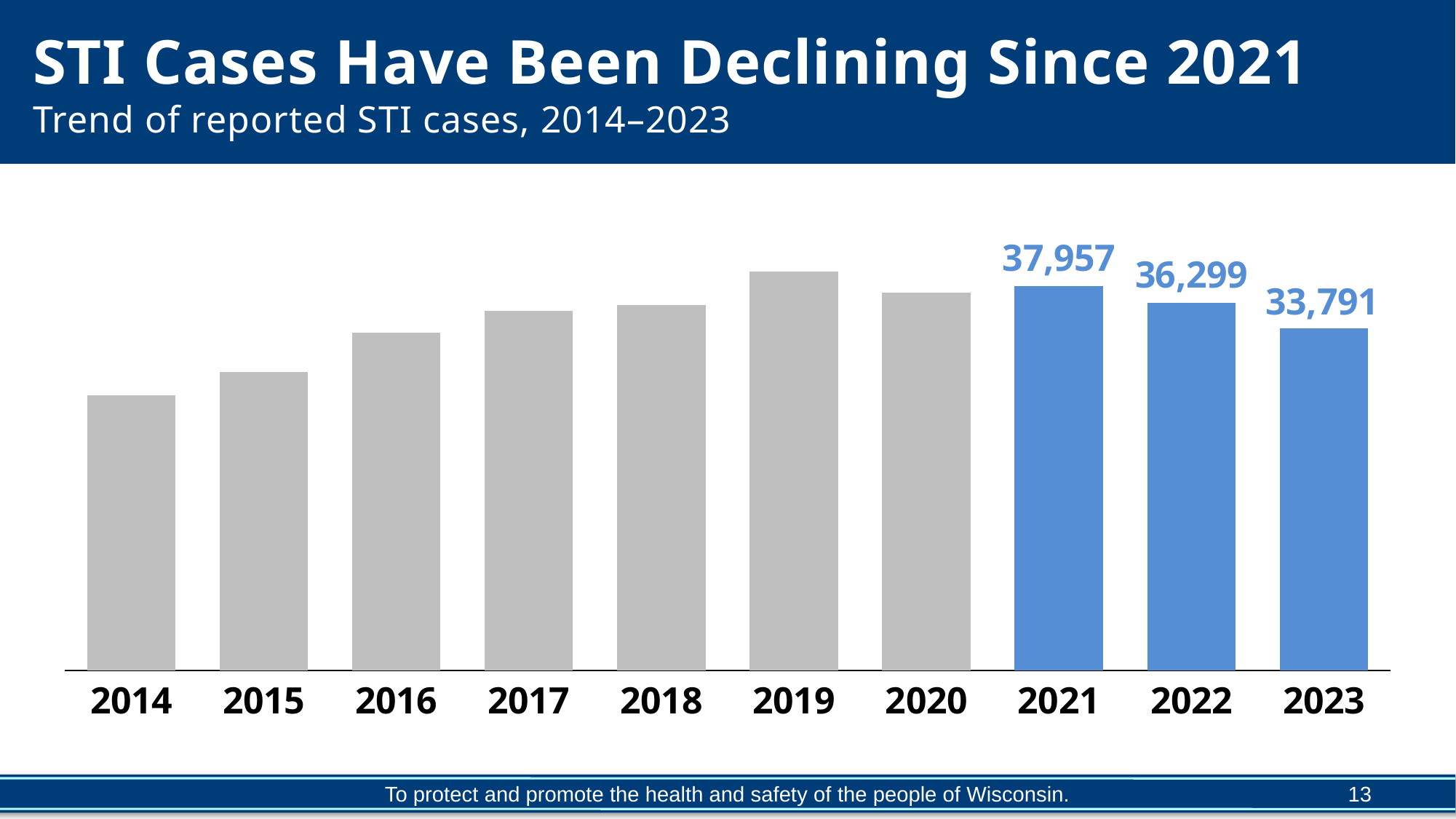
Which is larger, the value for 2019 or the value for 2014? 2019 What is the difference between the values for 2022 and 2023? 2,508 Do the values rise or fall from 2021 to 2023? Fall What is the difference between the values for 2021 and 2022? 1,658 What is the difference between the values for 2021 and 2023? 4,166 What is the value for 2022? 36,299 How many years are shown on the x axis? 10 Which year has the highest bar? 2019 What kind of chart is shown on the slide? Bar chart What is the value for 2021? 37,957 Which year has the lowest bar? 2014 What is the value for 2023? 33,791